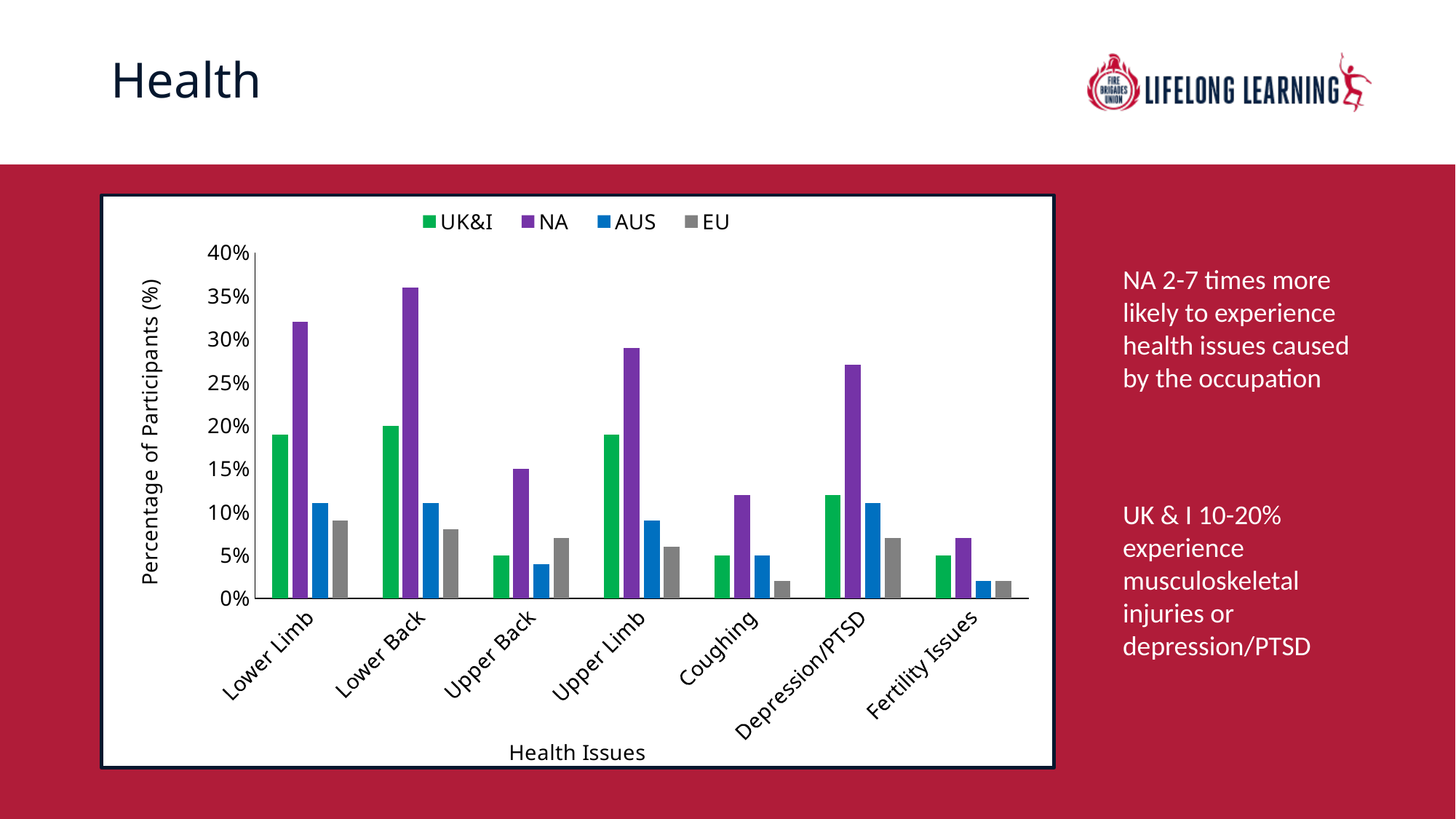
How many health issue categories are shown on the x axis? 7 How many series does the legend list? 4 For which health issue is the NA value highest? Lower Back What is the title of the horizontal axis? Health Issues What is the title of the vertical axis? Percentage of Participants (%) Is the AUS value for Lower Limb greater or less than 10%? greater For Upper Back, which is larger: the AUS value or the EU value? EU For Lower Limb, which is larger: the NA value or the UK&I value? NA Is the NA value for Lower Back greater or less than 30%? greater Is the EU value for Coughing greater or less than 5%? less What kind of chart is shown on the slide? Bar chart For which health issue is the NA value lowest? Fertility Issues